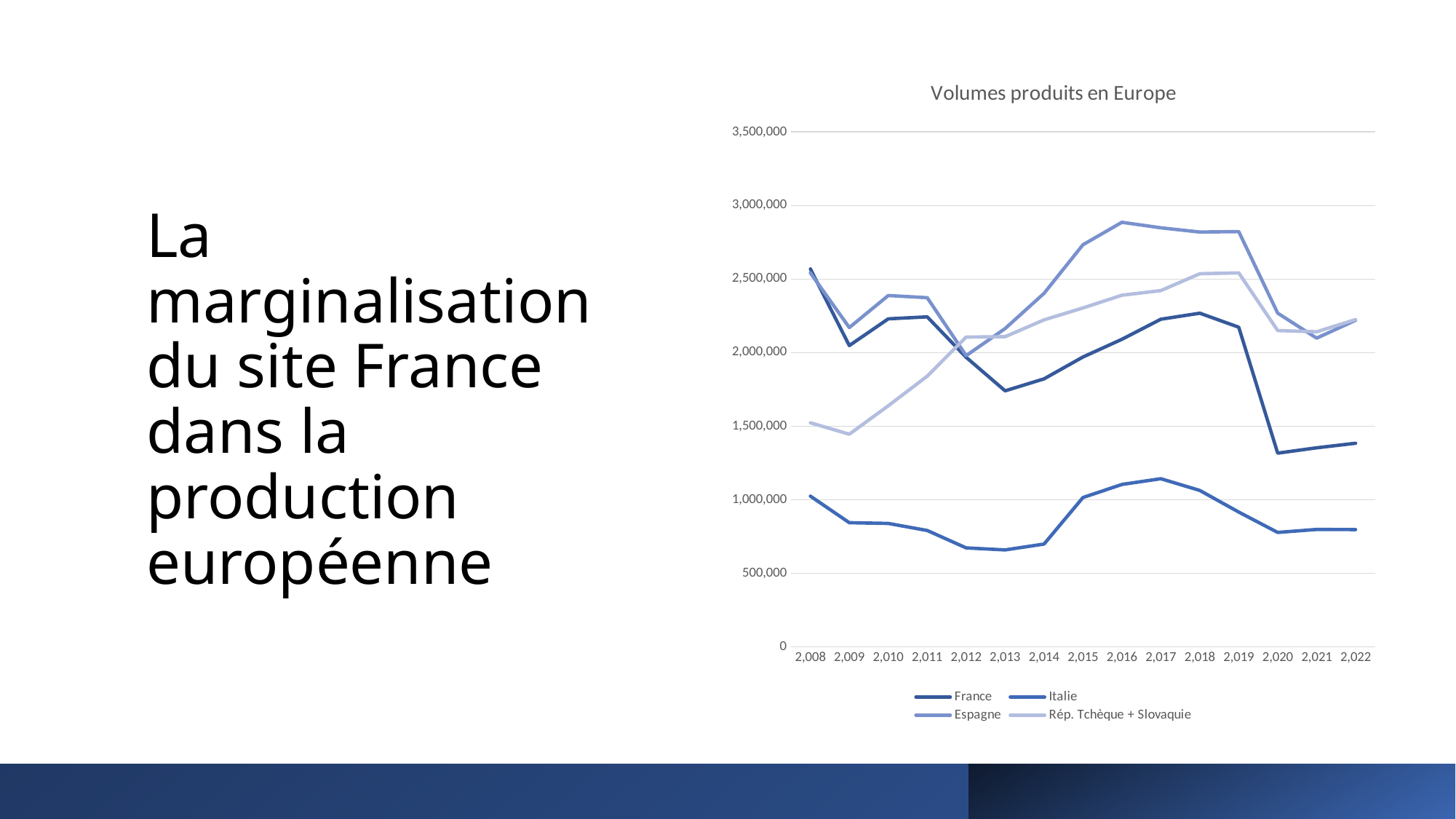
Is the value for Italie in 2013 greater or less than 1,000,000? less Which series has the highest value in 2016? Espagne Is the value for Rép. Tchèque + Slovaquie in 2009 greater or less than 1,500,000? less Does the France line rise or fall between 2019 and 2020? fall How many years are plotted along the x axis? 15 How many series does the legend list? 4 Is the value for France in 2020 greater or less than 1,500,000? less What is the title of the chart? Volumes produits en Europe In 2020, which is larger: the value for France or the value for Espagne? Espagne Which series has the lowest value in 2022? Italie What kind of chart is shown on the slide? line chart